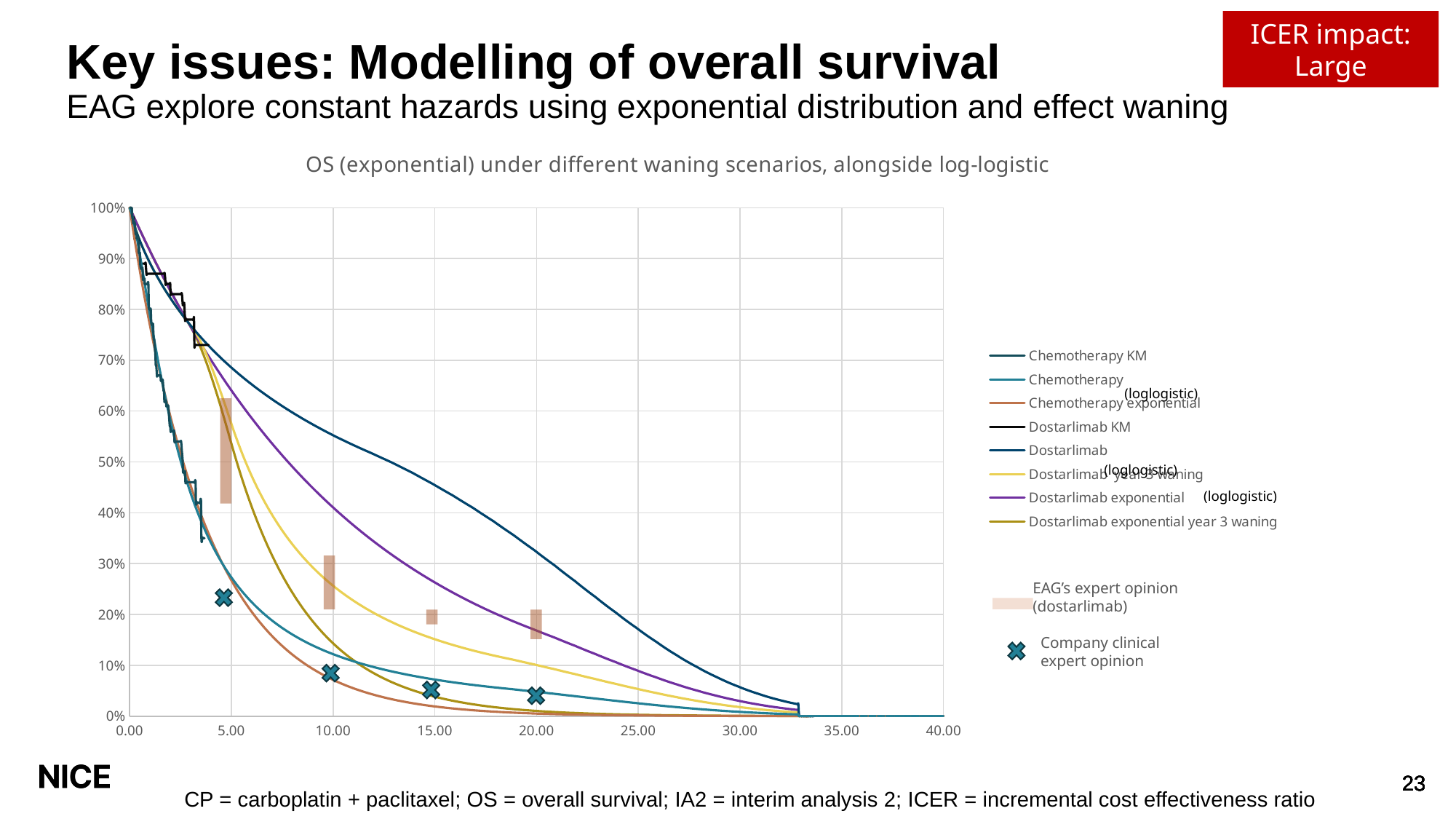
Do the survival curves rise or fall as the x axis increases? Fall How many Company clinical expert opinion markers are plotted on the chart? 4 Is the value for Dostarlimab exponential year 3 waning at x = 15.00 greater or less than 10%? less At x = 15.00, which is higher: Dostarlimab exponential or Dostarlimab year 3 waning (loglogistic)? Dostarlimab exponential Is the value for Dostarlimab (loglogistic) at x = 20.00 greater or less than 30%? greater What is the title of the chart? OS (exponential) under different waning scenarios, alongside log-logistic What is the maximum value shown on the y axis? 100% Which series has the highest value at x = 20.00? Dostarlimab (loglogistic) Is the value for Chemotherapy exponential at x = 10.00 greater or less than 10%? less Which series has the lowest value at x = 10.00? Chemotherapy exponential What kind of chart is shown on the slide? Line chart How many line series does the chart legend list (excluding the expert opinion markers)? 8